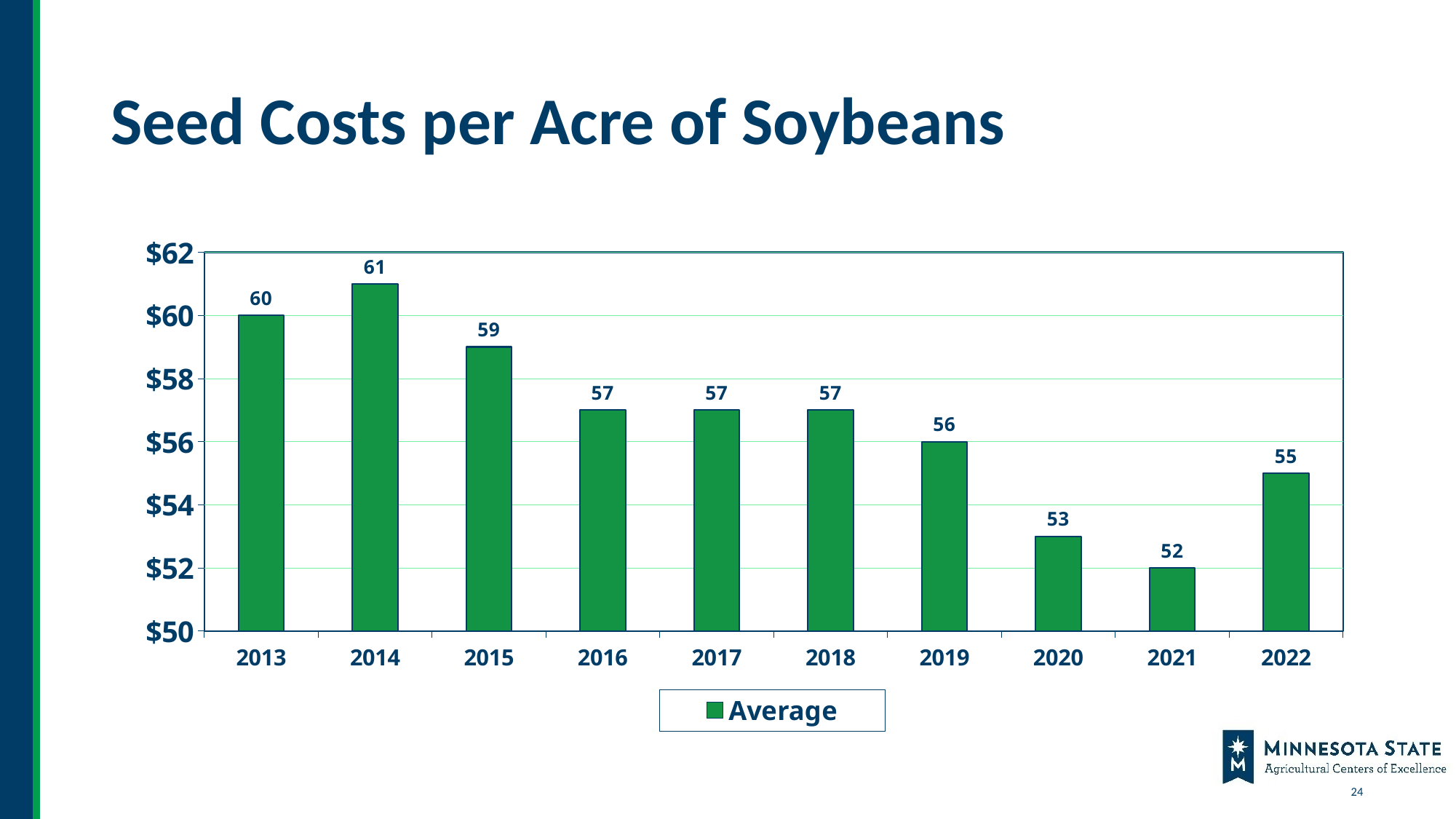
Which year has the highest seed cost per acre? 2014 What is the seed cost per acre of soybeans in 2022? 55 What kind of chart is shown on the slide? bar chart What is the seed cost per acre of soybeans in 2014? 61 Is the value for 2015 greater or less than $58? greater What is the seed cost per acre of soybeans in 2021? 52 Which year has the lowest seed cost per acre? 2021 What is the single legend entry for the chart? Average Which is larger, the seed cost in 2019 or the seed cost in 2022? 2019 What is the difference between the seed cost in 2013 and the seed cost in 2020? 7 How many years are shown on the x axis? 10 What is the difference between the seed cost in 2014 and the seed cost in 2021? 9